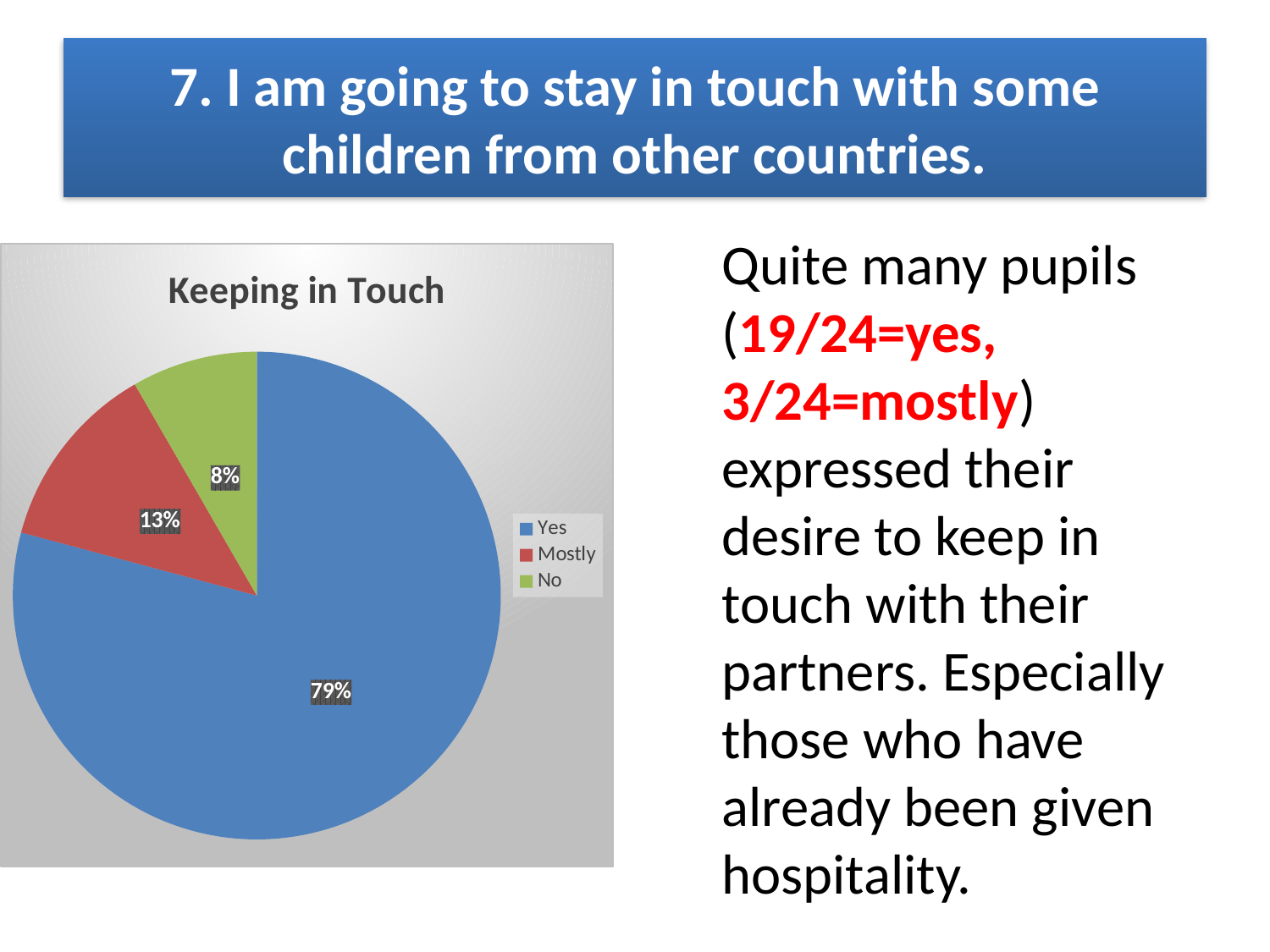
What is the difference in percentage points between the 'Yes' slice and the 'Mostly' slice? 66 Which category has the largest share of the pie? Yes What is the difference in percentage points between the 'Mostly' slice and the 'No' slice? 5 How many categories does the legend list? 3 What type of chart is shown on the slide? pie chart What percentage of the pie is the 'No' slice? 8% Which category has the smallest share of the pie? No What percentage of the pie is the 'Mostly' slice? 13% What is the title of the chart? Keeping in Touch What percentage of the pie is the 'Yes' slice? 79% What colour is the 'Yes' slice? blue Which is larger, the 'Mostly' slice or the 'No' slice? Mostly